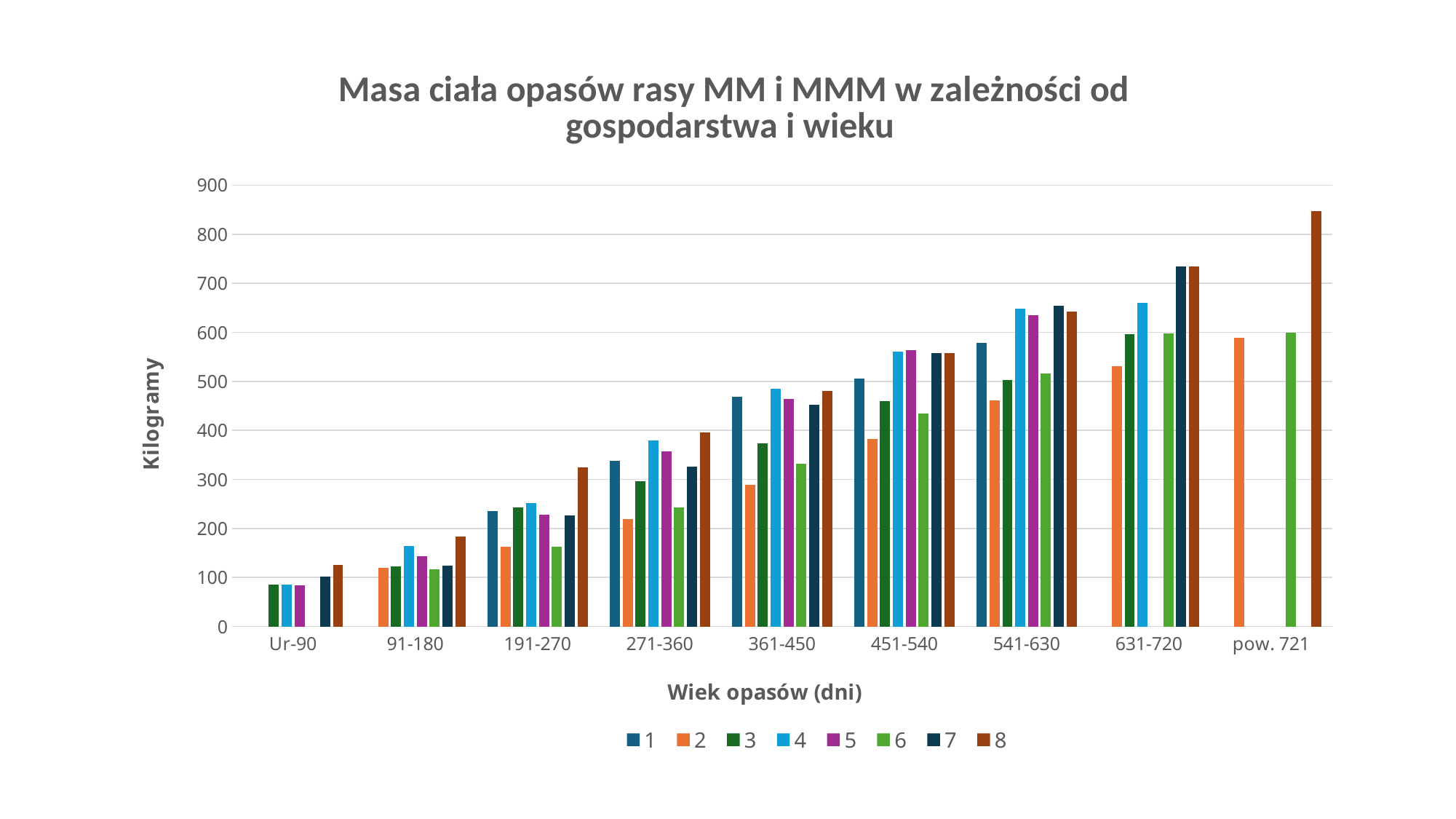
How many series does the legend list? 8 In the 'pow. 721' category, which series has the highest value? 8 Is the value for series 8 in the 'pow. 721' category greater or less than 800? greater Is the value for series 2 in the '361-450' category greater or less than 300? less What is the title of the y axis? Kilogramy What kind of chart is shown on the slide? bar chart Is the value for series 4 in the '631-720' category greater or less than 600? greater In the '541-630' category, which series has the lowest value? 2 In the '191-270' category, which series has the highest value? 8 How many age categories are shown on the x axis? 9 Do the values for series 8 rise or fall as age increases along the x axis? rise In the '191-270' category, which is larger: series 8 or series 1? 8